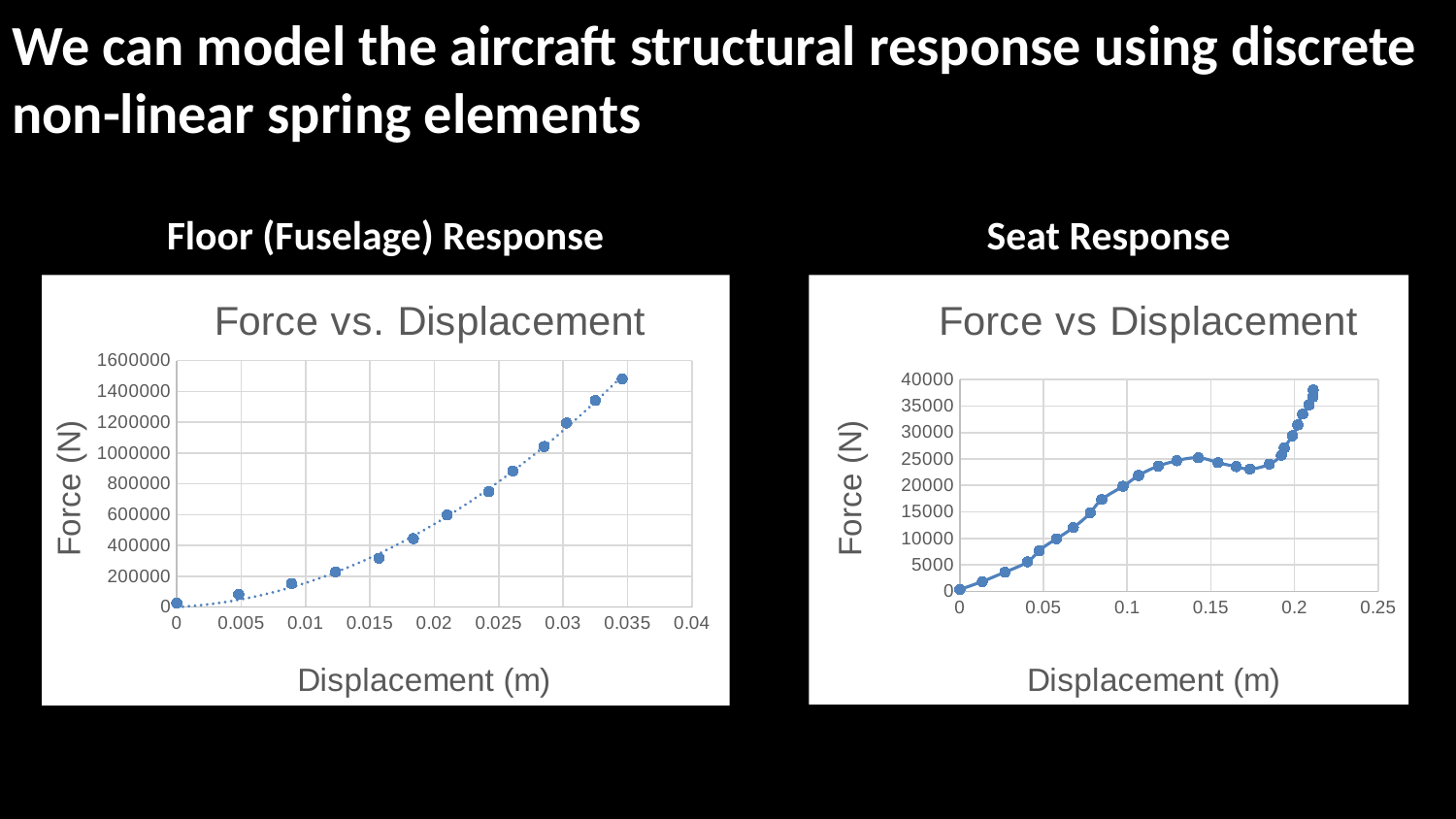
In the Seat Response chart, is the force at a displacement of 0.05 m greater or less than 10000? less In the Floor (Fuselage) Response chart, does force rise or fall as displacement increases? rise In the Seat Response chart, does force generally rise or fall as displacement increases from 0 to 0.2 m? rise What type of chart is the Seat Response chart? scatter chart In the Seat Response chart, is the force at a displacement of 0.2 m greater or less than 25000? greater In the Floor (Fuselage) Response chart, is the force at a displacement of 0.035 m greater or less than 1400000? greater What is the title of the chart under the Seat Response heading? Force vs Displacement What is the y-axis label on the Floor (Fuselage) Response chart? Force (N) What type of chart is the Floor (Fuselage) Response chart? scatter chart